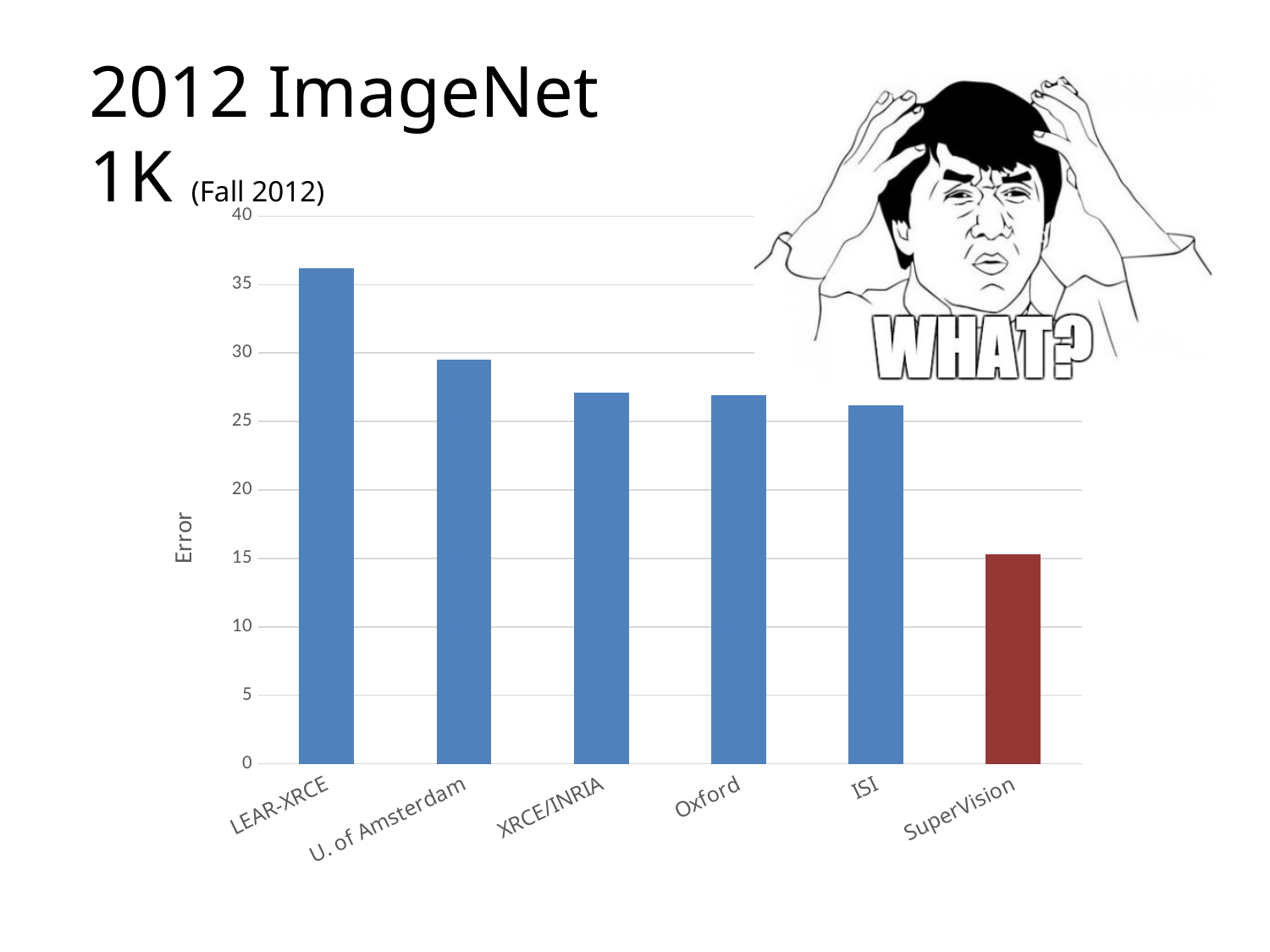
What kind of chart is shown on the slide? bar chart Which team has the highest error in the chart? LEAR-XRCE Which has a higher error, LEAR-XRCE or U. of Amsterdam? LEAR-XRCE What is the label on the y axis of the chart? Error Which has a lower error, ISI or SuperVision? SuperVision How many categories (teams) are shown on the x axis of the chart? 6 Which team has the lowest error in the chart? SuperVision Is the error for SuperVision greater or less than 20? less Do the error values rise or fall moving from left to right along the x axis? fall Is the error for LEAR-XRCE greater or less than 35? greater Is the error for ISI greater or less than 25? greater